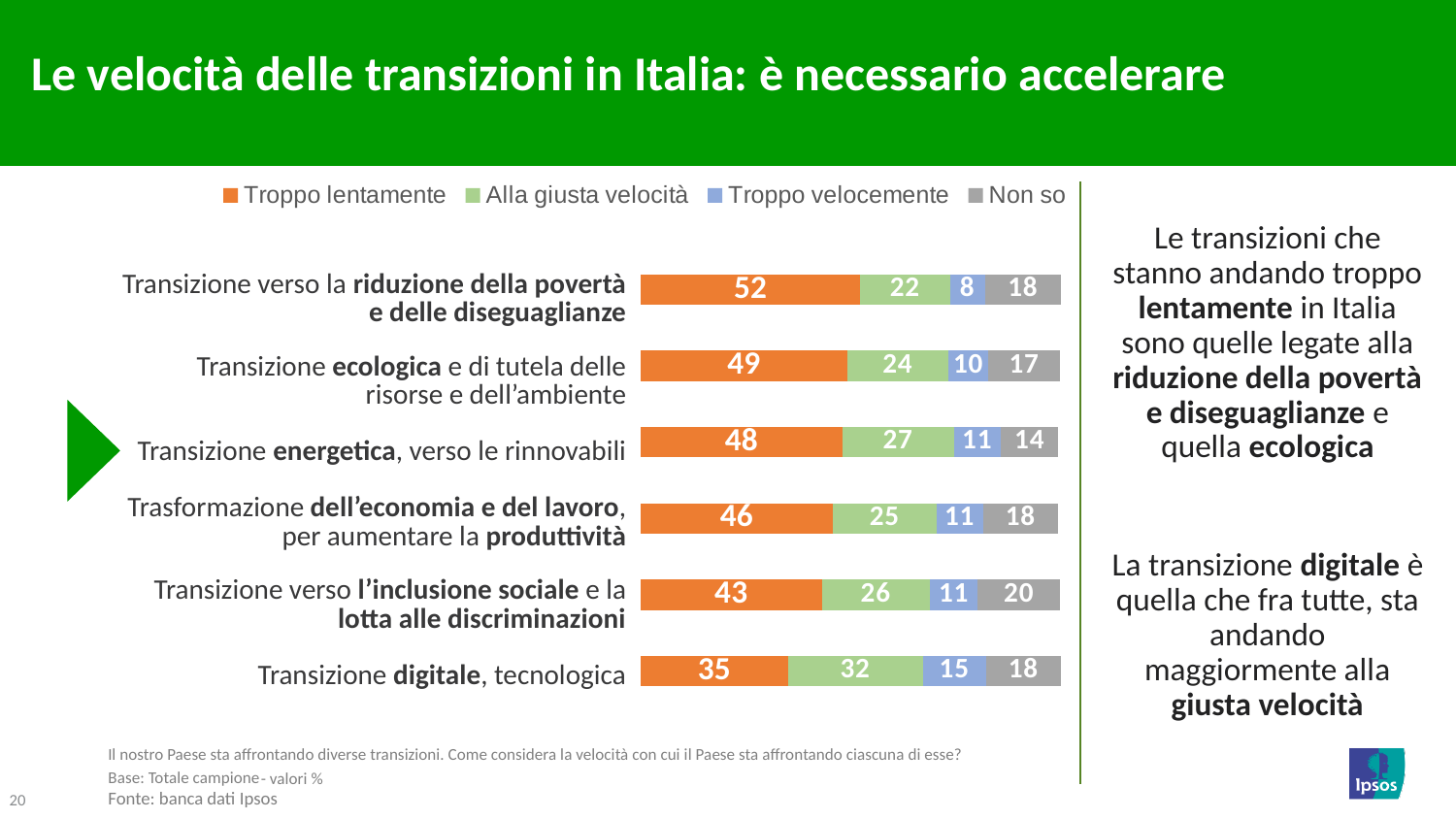
Which category has the highest "Troppo lentamente" value? Transizione verso la riduzione della povertà e delle diseguaglianze What is the difference between the "Troppo lentamente" values for "Transizione verso la riduzione della povertà e delle diseguaglianze" and "Transizione digitale, tecnologica"? 17 What kind of chart is shown on the slide? Stacked bar chart Which is larger: the "Non so" value for "Transizione energetica, verso le rinnovabili" or for "Transizione verso l'inclusione sociale e la lotta alle discriminazioni"? Transizione verso l'inclusione sociale e la lotta alle discriminazioni What is the "Alla giusta velocità" value for "Transizione energetica, verso le rinnovabili"? 27 How many categories are shown in the chart? 6 How many series does the legend list? 4 Which category has the lowest "Troppo lentamente" value? Transizione digitale, tecnologica What is the "Non so" value for "Transizione verso l'inclusione sociale e la lotta alle discriminazioni"? 20 What is the "Troppo velocemente" value for "Transizione ecologica e di tutela delle risorse e dell'ambiente"? 10 Which category has the highest "Alla giusta velocità" value? Transizione digitale, tecnologica What is the "Troppo lentamente" value for "Transizione digitale, tecnologica"? 35